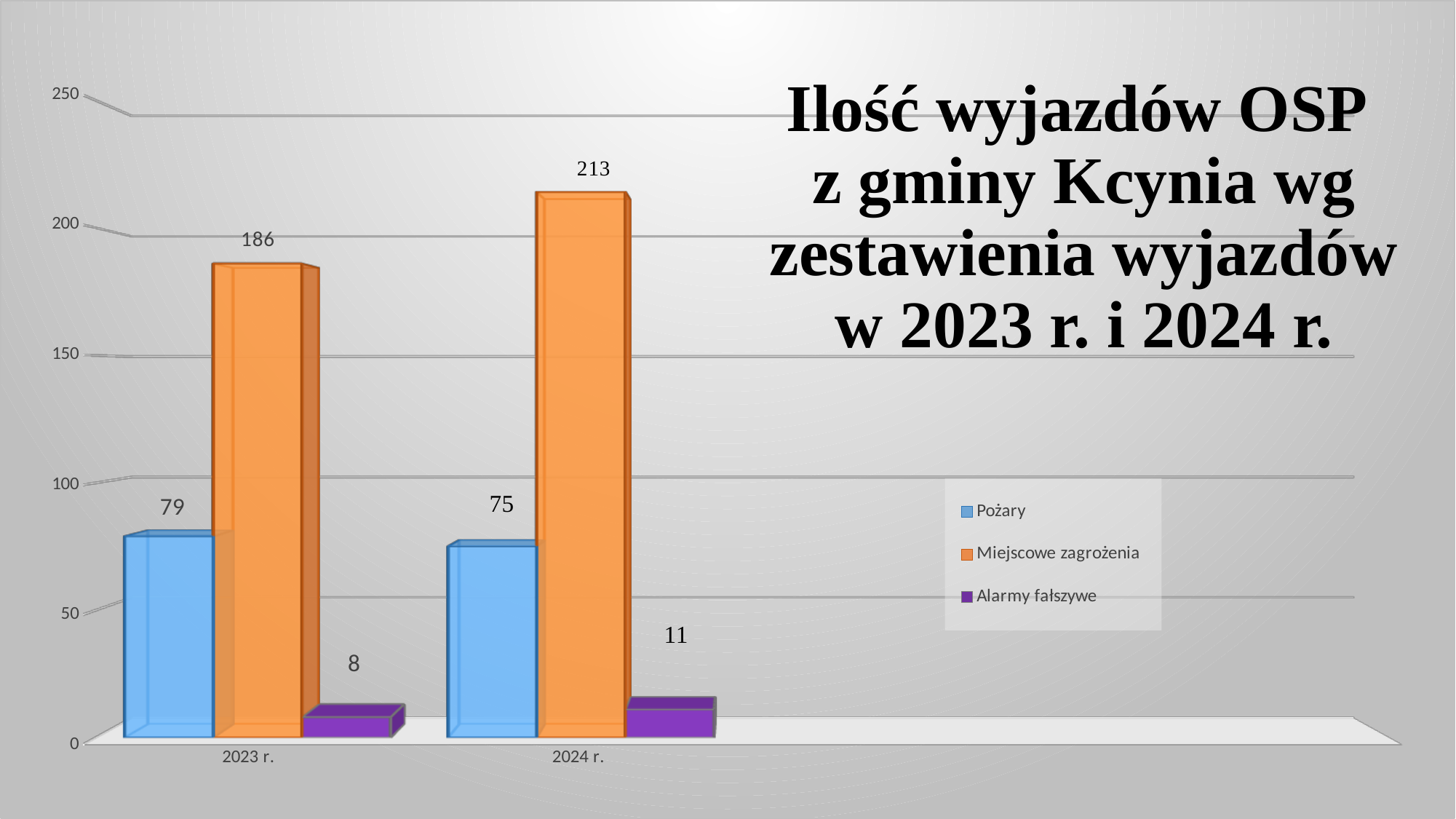
Is the value for Miejscowe zagrożenia in 2024 r. greater or less than 200? greater What is the difference between Miejscowe zagrożenia in 2024 r. and in 2023 r.? 27 How many year categories are shown on the x axis? 2 What kind of chart is shown on the slide? bar chart Which colour represents Alarmy fałszywe in the legend? purple What is the value for Pożary in 2023 r.? 79 Which series has the lowest value in 2023 r.? Alarmy fałszywe How many series does the legend list? 3 What is the value for Alarmy fałszywe in 2023 r.? 8 Which series has the highest value in 2024 r.? Miejscowe zagrożenia Which is larger: Pożary in 2023 r. or Pożary in 2024 r.? Pożary in 2023 r. What is the value for Miejscowe zagrożenia in 2024 r.? 213